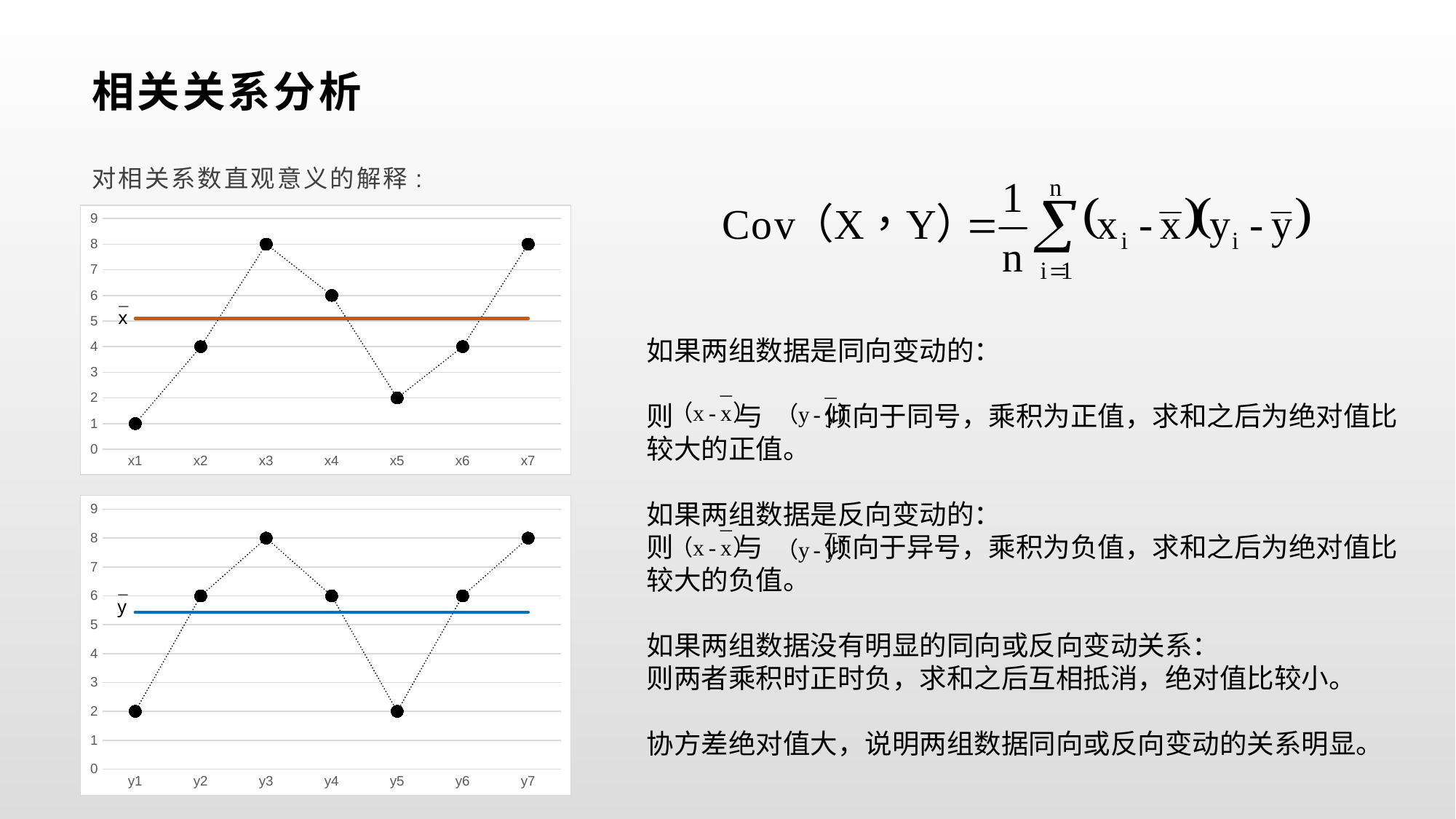
In the bottom chart, what is the value at y5? 2 In the top chart, do the values rise or fall from x1 to x3? rise In the top chart, which is larger, the value at x2 or the value at x4? x4 In the bottom chart, what is the value at y4? 6 In the top chart, what is the value at x5? 2 In the top chart, which category has the lowest value? x1 In the top chart, what is the difference between the values at x3 and x1? 7 In the top chart, what is the value at x3? 8 In the bottom chart, is the horizontal ȳ line greater or less than 5? greater In the top chart, what is the value at x1? 1 What kind of chart is the top chart? line chart How many data points are plotted in the bottom chart? 7